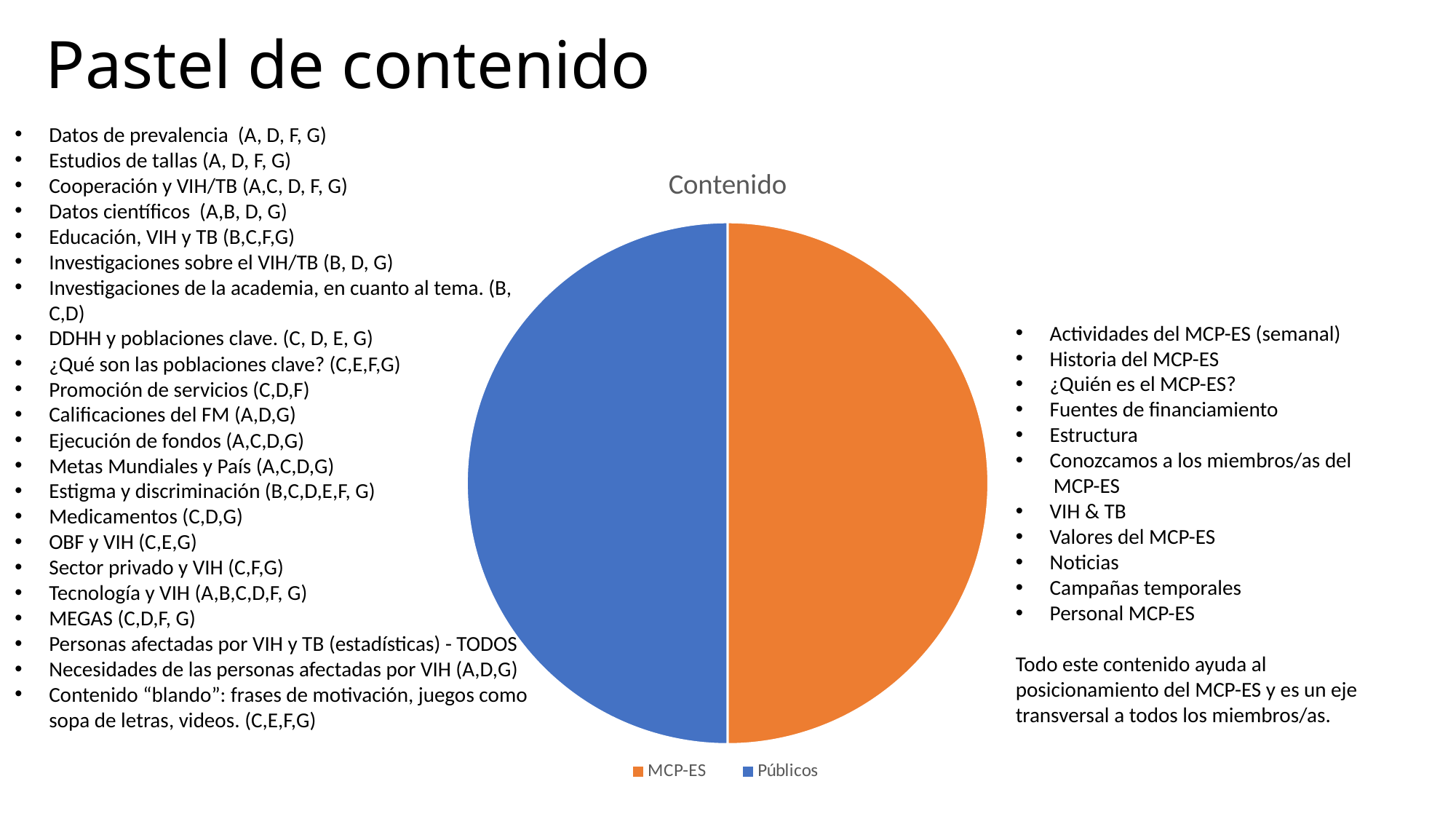
How many slices does the pie chart have? 2 What kind of chart is shown on the slide? pie chart How many entries does the chart legend list? 2 Which legend entry is shown in orange? MCP-ES What is the title of the chart? Contenido Which category is represented by the blue slice? Públicos